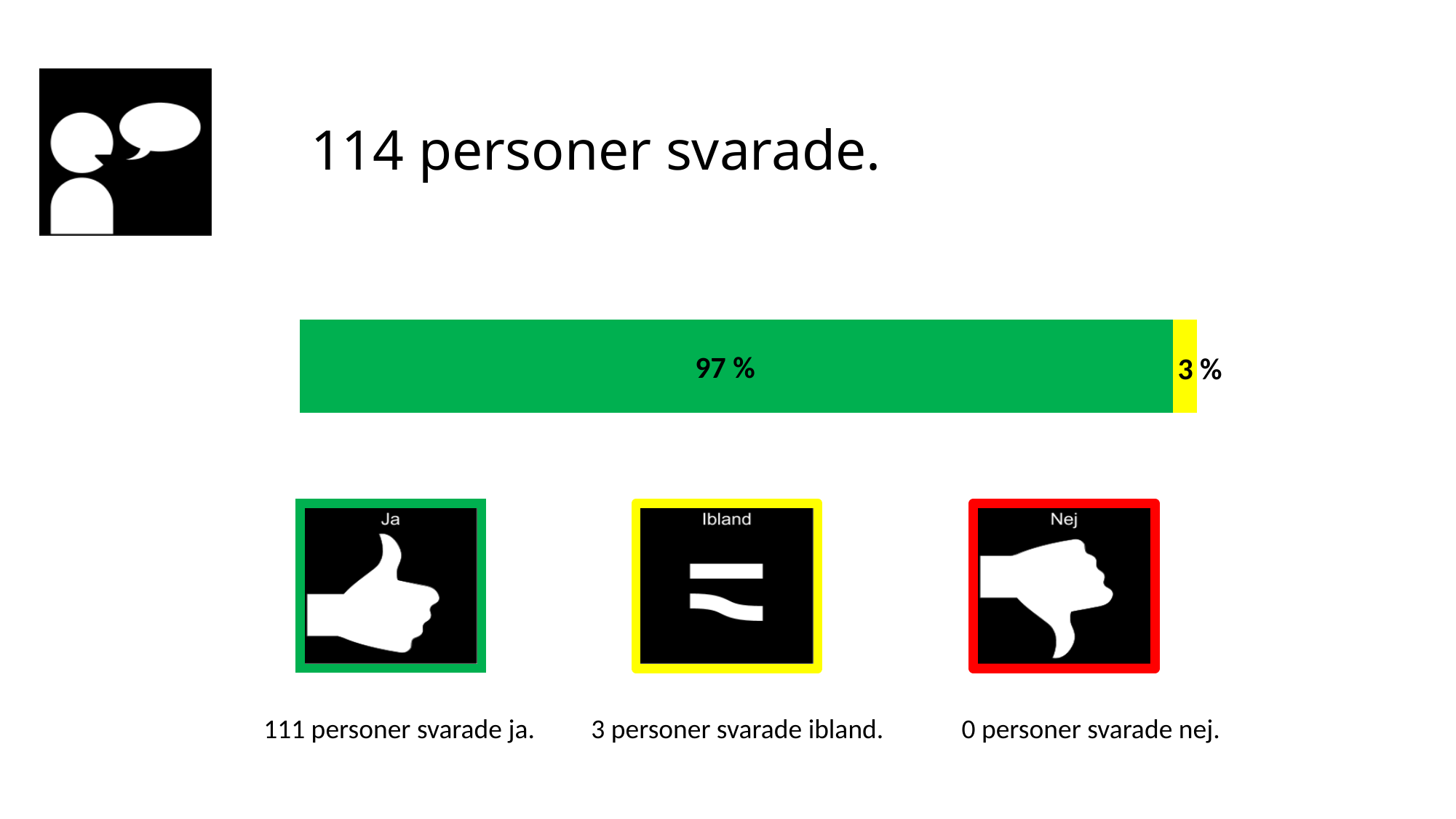
Is the green segment or the yellow segment larger? the green segment What is the total of the two segments in the stacked bar? 100 % Which segment of the bar is the smallest? the yellow segment (3 %) What value is printed on the green segment of the bar? 97 % Based on the icons below the bar, which answer does the green segment correspond to? Ja Which segment of the bar is the largest? the green segment (97 %) What kind of chart is shown on the slide? bar chart What value is printed on the yellow segment of the bar? 3 % What colour is the segment labelled 97 %? green What is the difference between the green segment's value and the yellow segment's value? 94 % How many segments does the stacked bar contain? 2